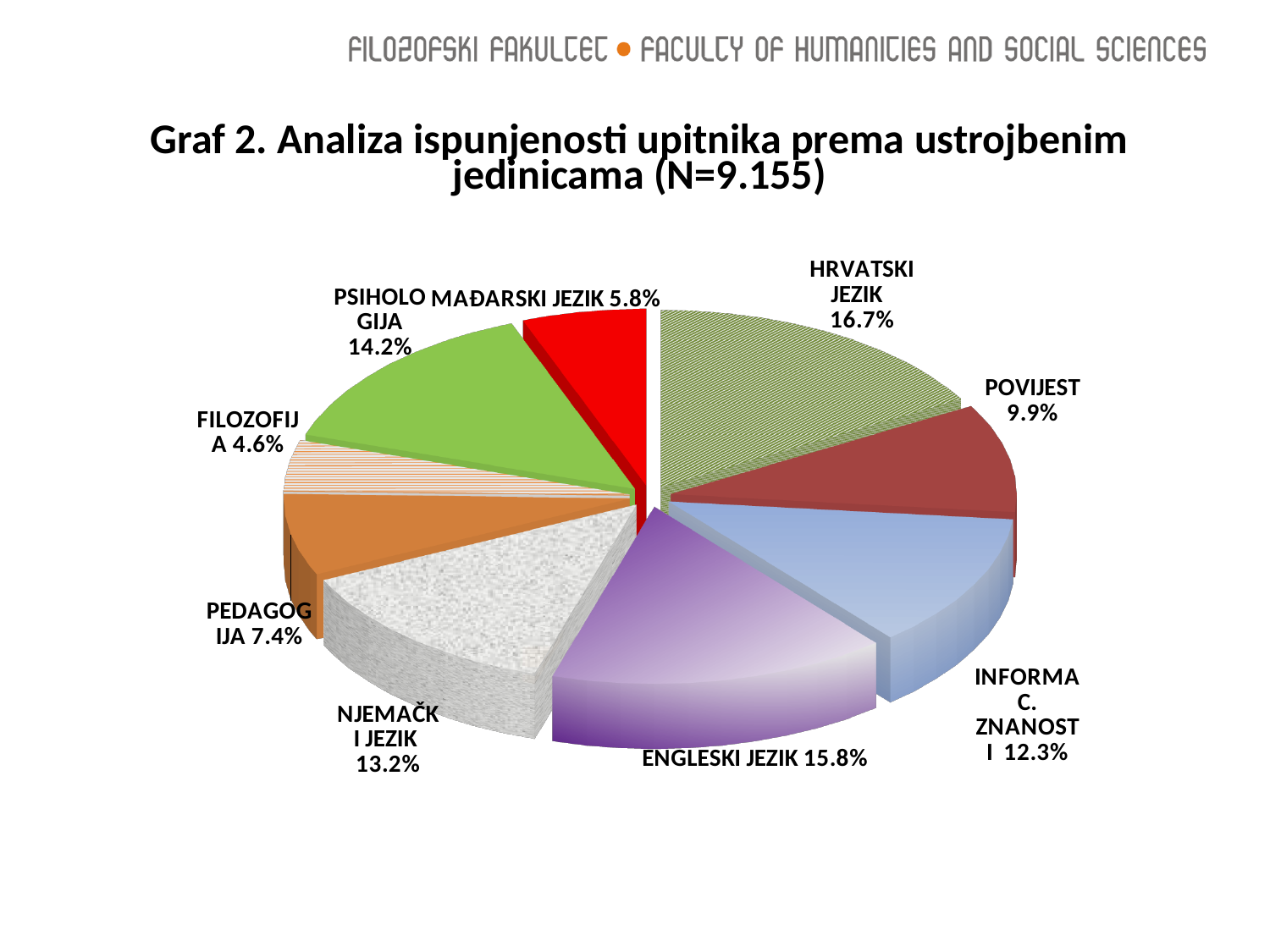
What is the difference between the shares of HRVATSKI JEZIK and ENGLESKI JEZIK? 0.9% Which has a larger share, POVIJEST or MAĐARSKI JEZIK? POVIJEST What is the share for ENGLESKI JEZIK? 15.8% How many slices does the pie chart have? 9 What kind of chart is shown on the slide? pie chart What is the share for INFORMAC. ZNANOSTI? 12.3% Which category has the largest share of the pie? HRVATSKI JEZIK Which category has the smallest share of the pie? FILOZOFIJA What is the difference between the shares of PSIHOLOGIJA and NJEMAČKI JEZIK? 1.0% What is the share for HRVATSKI JEZIK? 16.7% What is the title of the chart? Graf 2. Analiza ispunjenosti upitnika prema ustrojbenim jedinicama (N=9.155) What is the share for PEDAGOGIJA? 7.4%